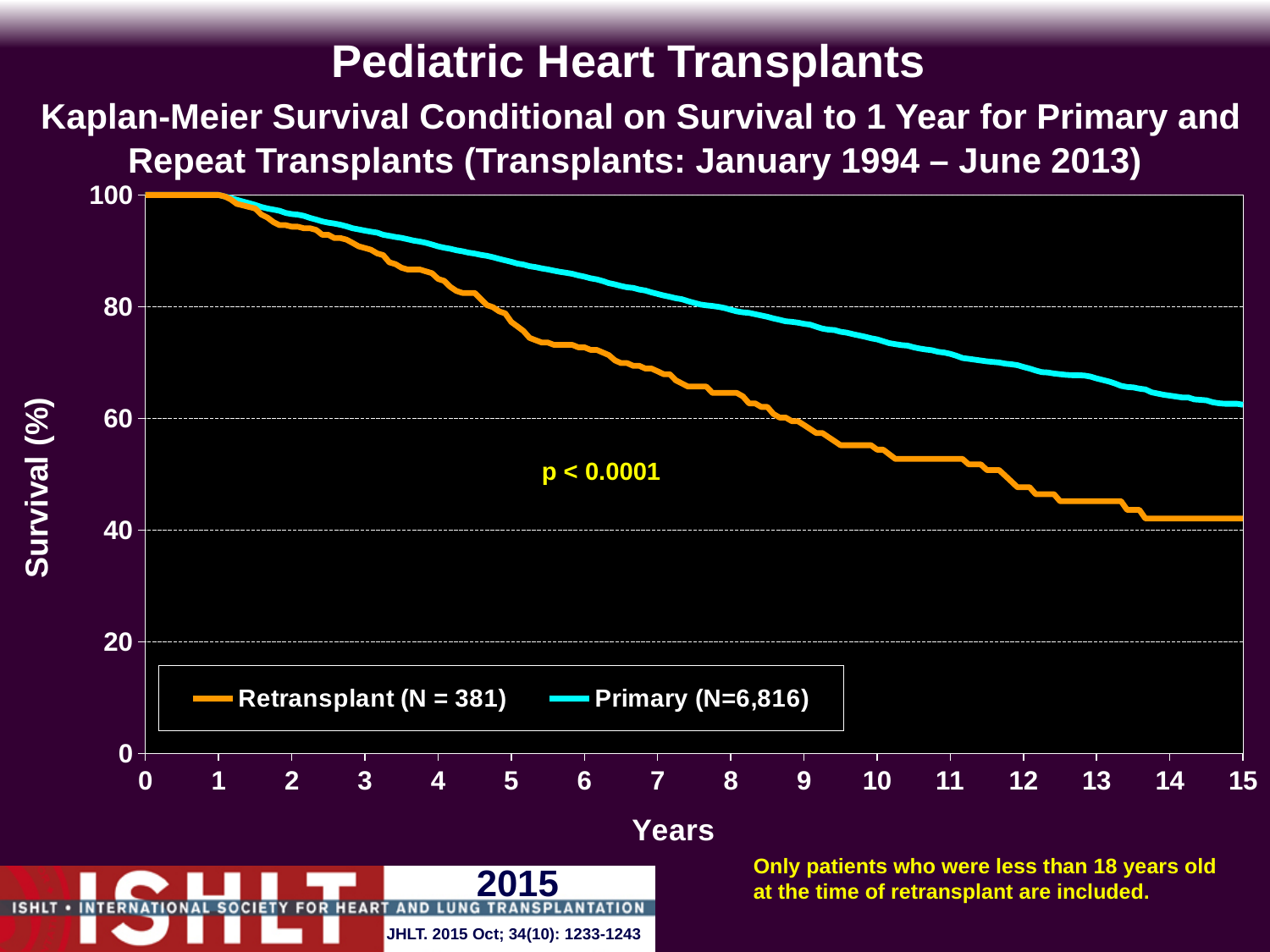
Do the survival values for the Primary series rise or fall along the x axis? Fall What p-value is printed on the chart? p < 0.0001 Do the survival values for the Retransplant series rise or fall as years increase? Fall At 10 years, which series has the higher survival, Retransplant or Primary? Primary Is the survival value for the Retransplant series at 15 years greater or less than 40? greater At 15 years, which series has the lower survival, Retransplant or Primary? Retransplant How many series does the legend list? 2 Is the survival value for the Primary series at 15 years greater or less than 60? greater Which two series are listed in the legend? Retransplant (N = 381) and Primary (N=6,816) Is the survival value for the Primary series at 5 years greater or less than 80? greater What kind of chart is shown on the slide? Line chart